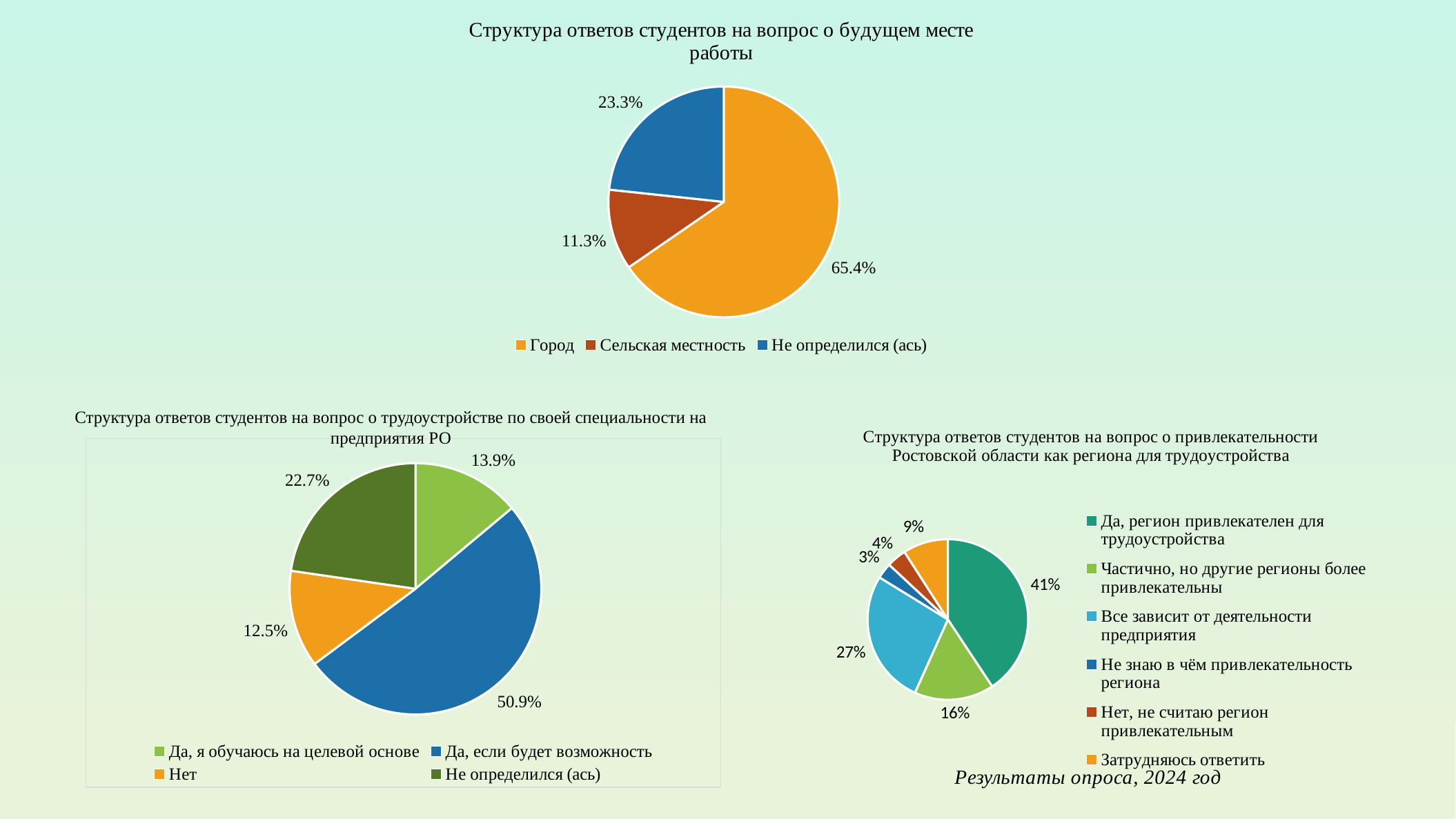
In the bottom-left chart about employment by specialty at enterprises of the Rostov region, how many categories does the legend list? 4 In the bottom-left chart about employment by specialty at enterprises of the Rostov region, which is larger: 'Да, я обучаюсь на целевой основе' or 'Не определился (ась)'? Не определился (ась) In the bottom-right chart about the attractiveness of the Rostov region for employment, what share of students answered 'Все зависит от деятельности предприятия'? 27% In the top chart 'Структура ответов студентов на вопрос о будущем месте работы', which category has the smallest share? Сельская местность What type of chart is the top chart 'Структура ответов студентов на вопрос о будущем месте работы'? Pie chart In the bottom-right chart about the attractiveness of the Rostov region for employment, which category has the largest share? Да, регион привлекателен для трудоустройства In the top chart 'Структура ответов студентов на вопрос о будущем месте работы', what share of students chose 'Город'? 65.4% In the bottom-right chart about the attractiveness of the Rostov region for employment, how many categories does the legend list? 6 In the bottom-left chart about employment by specialty at enterprises of the Rostov region, what share of students answered 'Нет'? 12.5% In the bottom-left chart about employment by specialty at enterprises of the Rostov region, what share of students answered 'Да, если будет возможность'? 50.9% In the top chart 'Структура ответов студентов на вопрос о будущем месте работы', what is the difference between the shares for 'Город' and 'Не определился (ась)'? 42.1% In the top chart 'Структура ответов студентов на вопрос о будущем месте работы', what share of students chose 'Сельская местность'? 11.3%